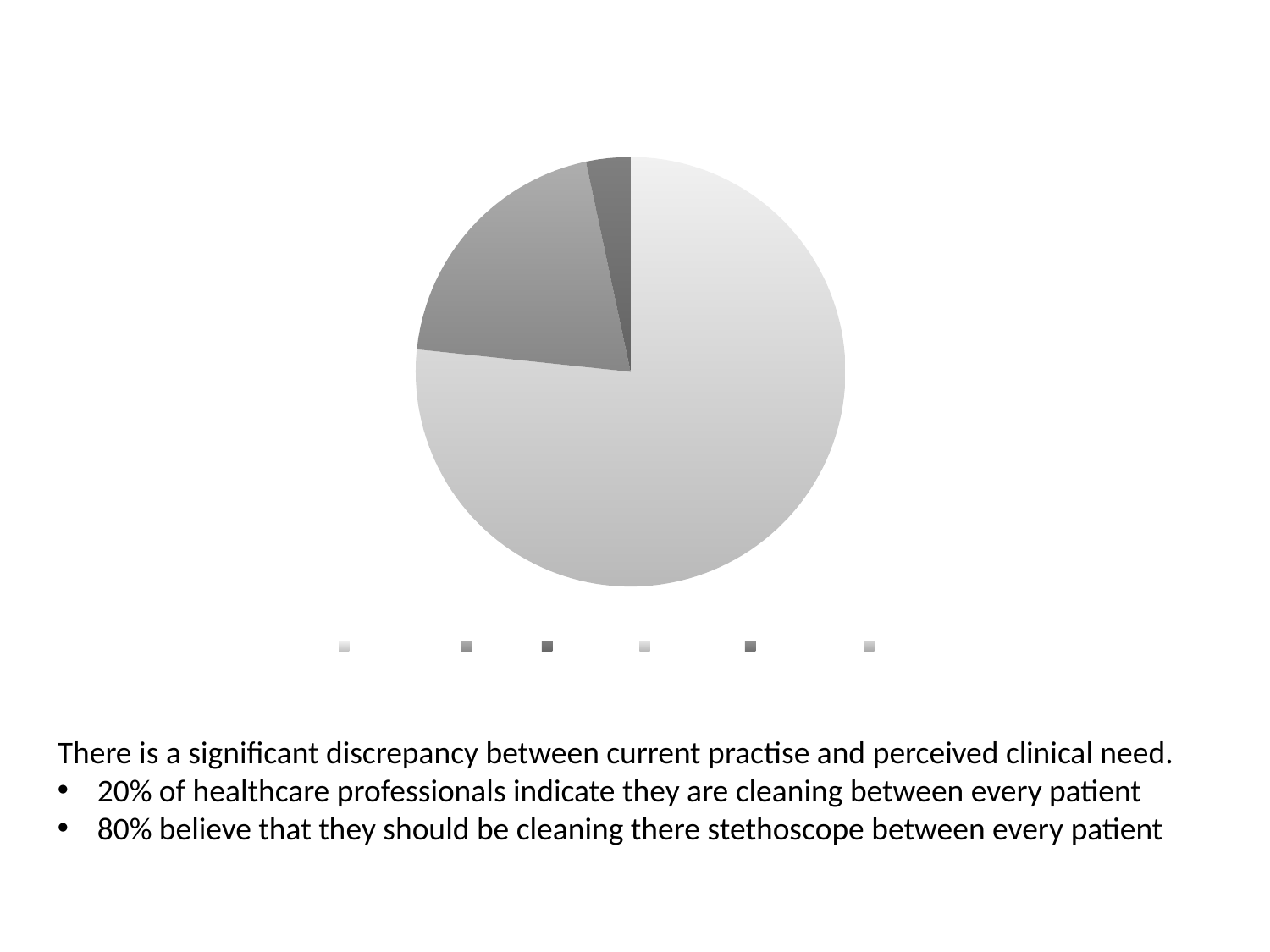
How many legend markers are shown below the pie chart? 6 In the pie chart, which is larger: the medium grey slice or the dark grey slice? medium grey Which slice of the pie chart is the largest: the light grey, the medium grey, or the dark grey slice? light grey Does the pie chart have a title displayed above it? No Which slice of the pie chart is the smallest: the light grey, the medium grey, or the dark grey slice? dark grey In the pie chart, which is larger: the light grey slice or the medium grey slice? light grey What kind of chart is shown on the slide? pie chart How many slices are visible in the pie chart? 3